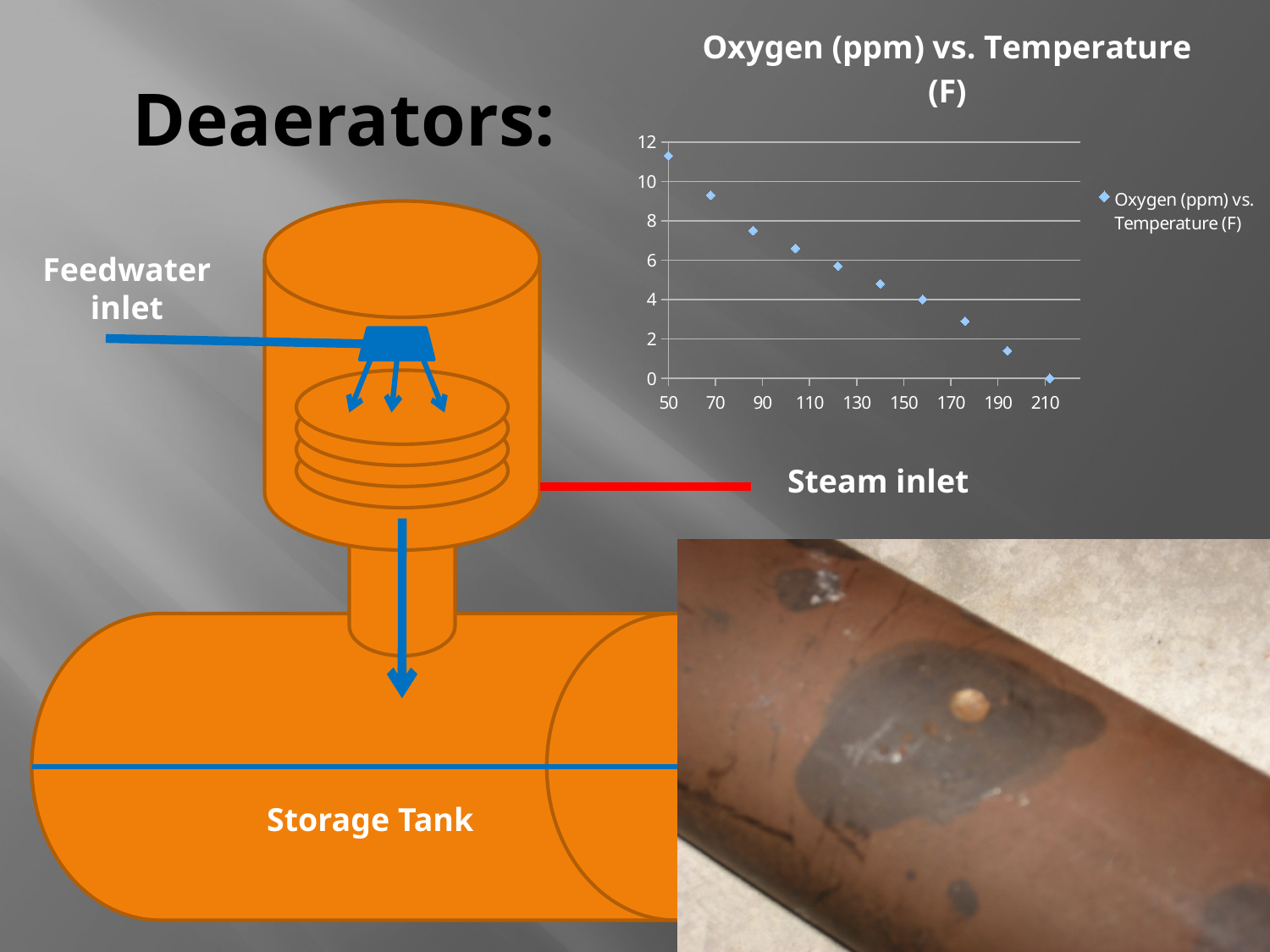
What is the title of the chart? Oxygen (ppm) vs. Temperature (F) Is the oxygen value at the rightmost point (around temperature 210) greater or less than 2? less At which temperature on the x axis is the oxygen value highest? 50 Is the oxygen value at the point around temperature 170 greater or less than 4? less Is the oxygen value at the leftmost point (temperature 50) greater or less than 10? greater How many data points are plotted in the chart? 10 Do the oxygen values rise or fall as temperature increases along the x axis? fall How many series does the chart legend list? 1 What kind of chart is shown on the slide? scatter chart Which has the larger oxygen value: the point at temperature 50 or the point around temperature 190? the point at temperature 50